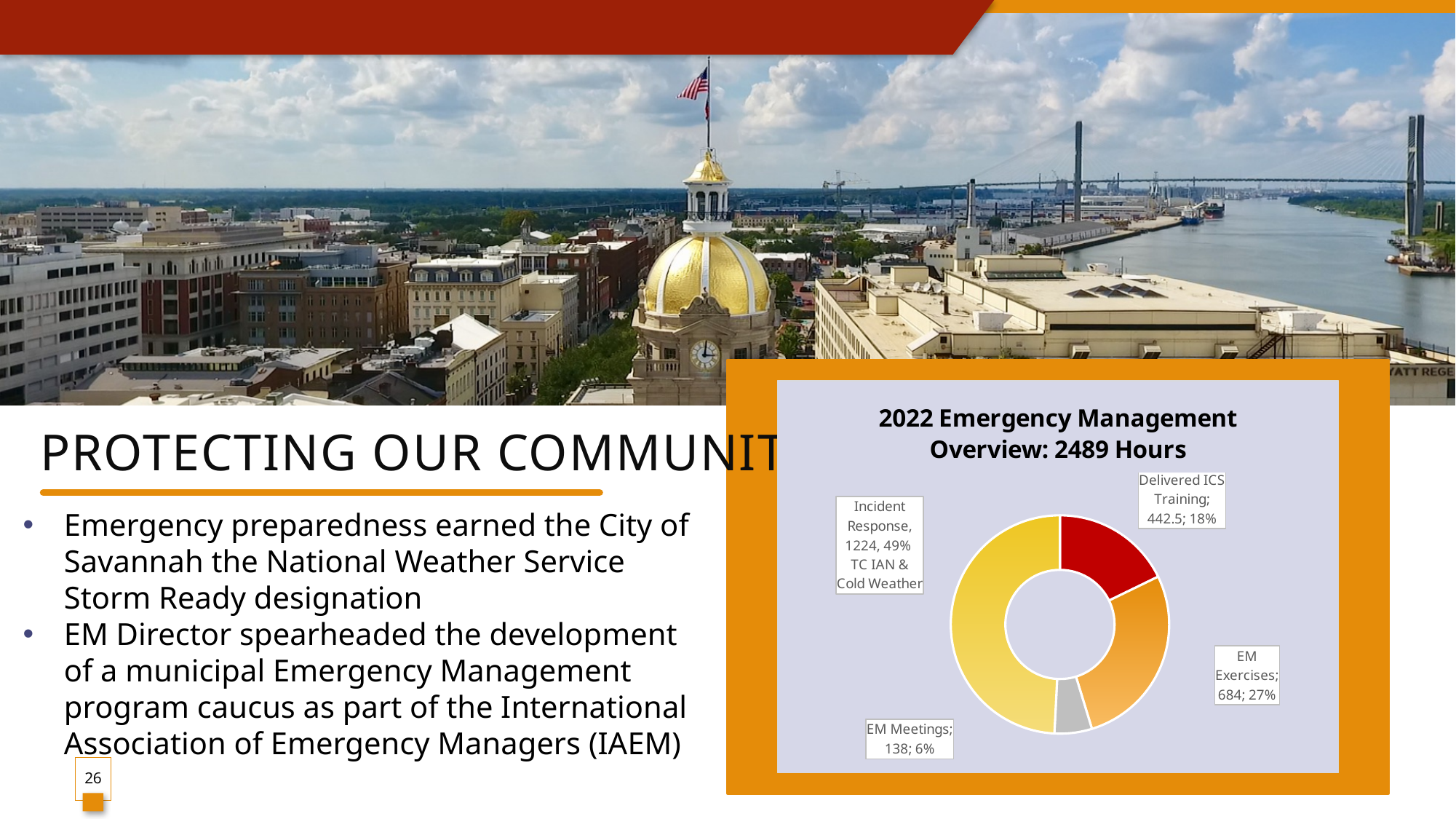
How many hours are shown for Incident Response? 1224 How many categories are shown in the chart? 4 How many hours are shown for EM Meetings? 138 What percentage share does EM Exercises have? 27% How many hours are shown for Delivered ICS Training? 442.5 Which category has the largest share of the chart? Incident Response What is the title of the chart? 2022 Emergency Management Overview: 2489 Hours What percentage share does Delivered ICS Training have? 18% How many hours are shown for EM Exercises? 684 What kind of chart is shown on the slide? Doughnut chart What is the difference in hours between EM Exercises and Delivered ICS Training? 241.5 Which category has the smallest share of the chart? EM Meetings